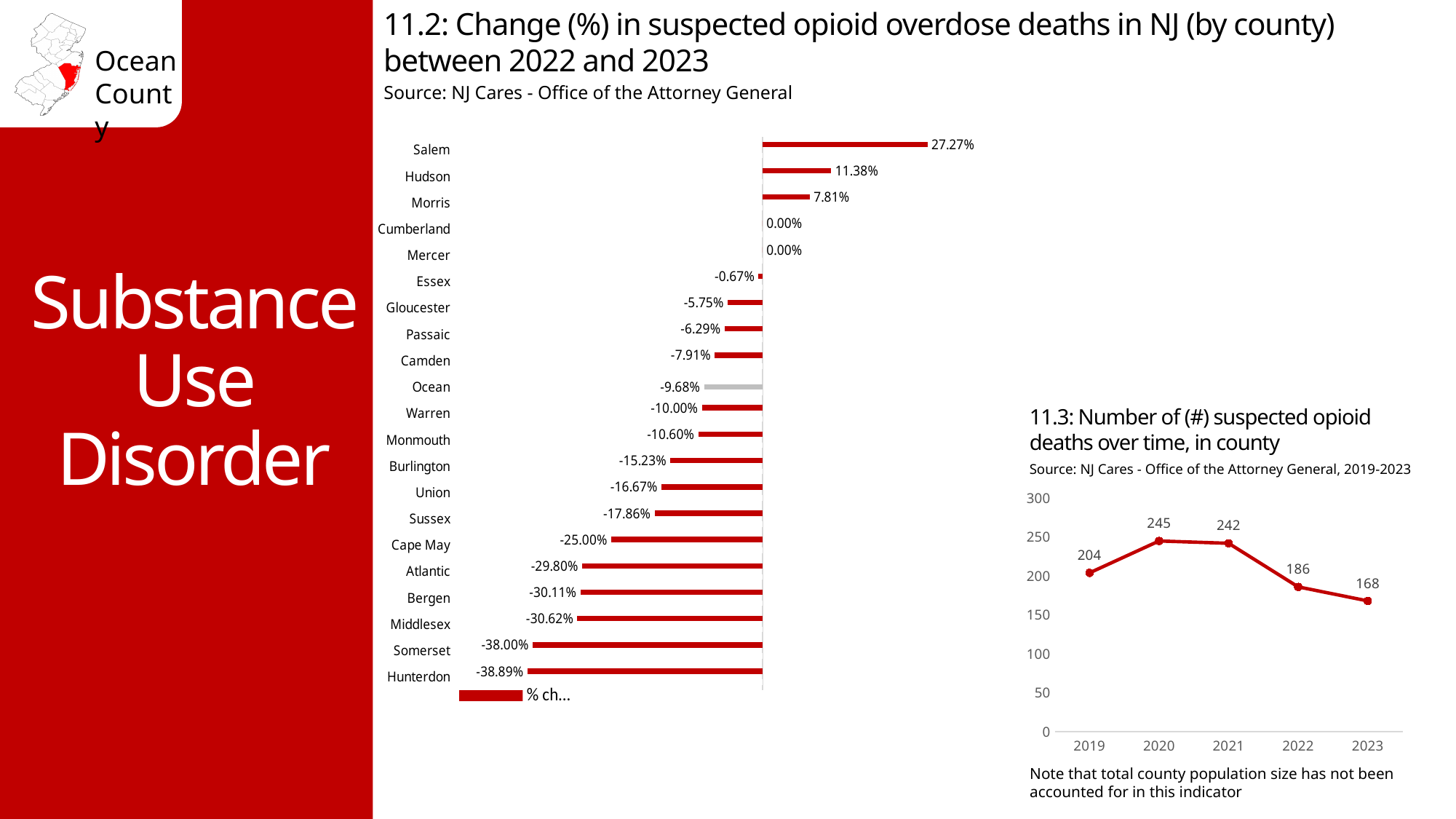
In the chart '11.3: Number of (#) suspected opioid deaths over time, in county', do the values rise or fall from 2021 to 2023? Fall What kind of chart is '11.2: Change (%) in suspected opioid overdose deaths in NJ (by county) between 2022 and 2023'? Bar chart In the chart '11.3: Number of (#) suspected opioid deaths over time, in county', what is the value for 2020? 245 In the chart '11.3: Number of (#) suspected opioid deaths over time, in county', which year has the lowest value? 2023 In the chart '11.2: Change (%) in suspected opioid overdose deaths in NJ (by county) between 2022 and 2023', what is the value for Ocean? -9.68% In the chart '11.2: Change (%) in suspected opioid overdose deaths in NJ (by county) between 2022 and 2023', which county has the highest value? Salem In the chart '11.3: Number of (#) suspected opioid deaths over time, in county', what is the difference between the 2019 value and the 2023 value? 36 In the chart '11.2: Change (%) in suspected opioid overdose deaths in NJ (by county) between 2022 and 2023', which county has the lowest value? Hunterdon In the chart '11.2: Change (%) in suspected opioid overdose deaths in NJ (by county) between 2022 and 2023', what is the value for Hudson? 11.38% In the chart '11.2: Change (%) in suspected opioid overdose deaths in NJ (by county) between 2022 and 2023', how many counties are shown? 21 In the chart '11.2: Change (%) in suspected opioid overdose deaths in NJ (by county) between 2022 and 2023', which is larger, the value for Atlantic or the value for Cape May? Cape May What kind of chart is '11.3: Number of (#) suspected opioid deaths over time, in county'? Line chart